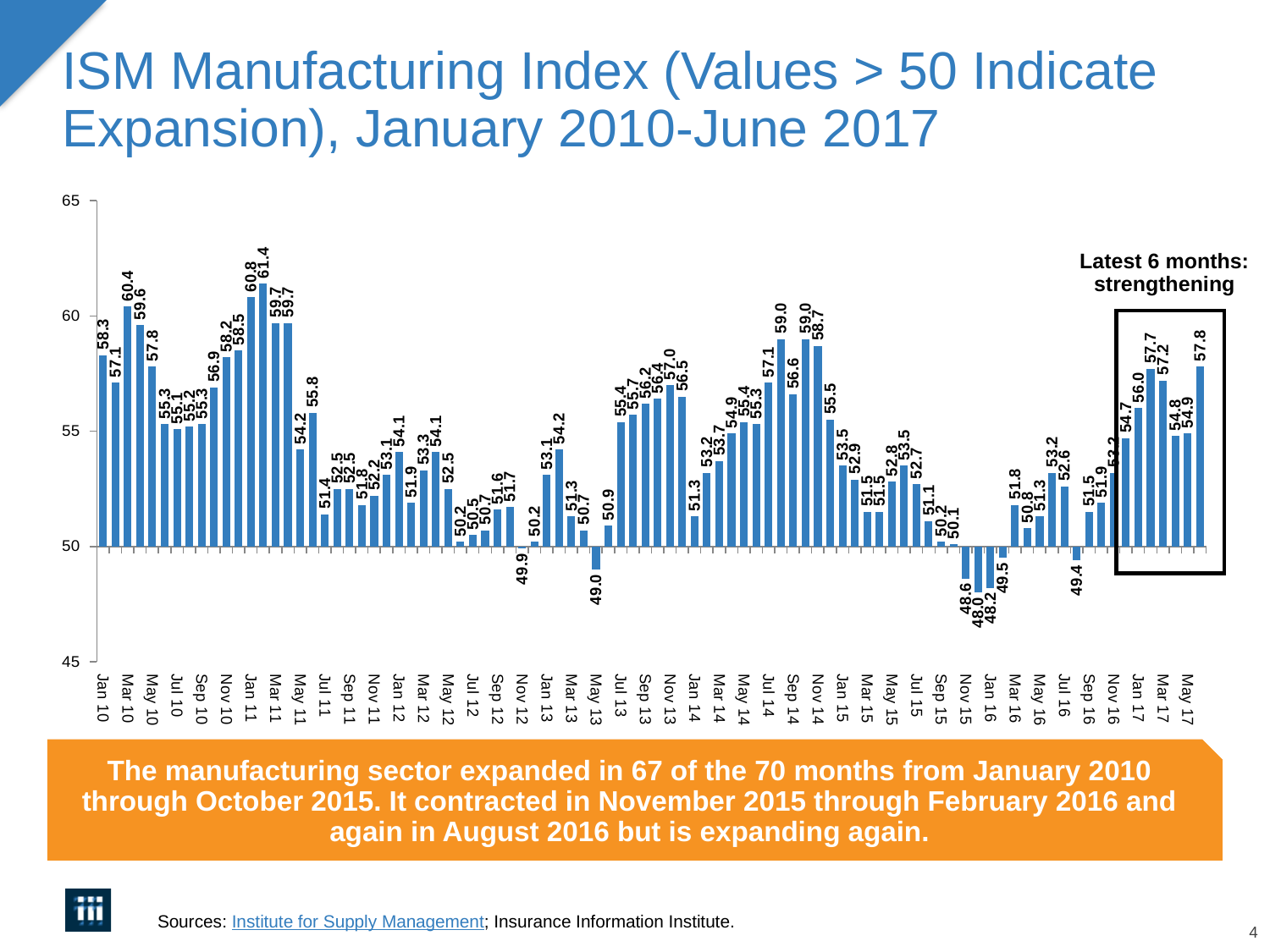
What is the ISM Manufacturing Index value for the last bar, Jun 17? 57.8 What is the lowest value shown on the chart? 48.0 What is the highest value shown on the chart? 61.4 How many bars on the chart have values below 50? 7 What is the ISM Manufacturing Index value for Jan 10? 58.3 What is the difference between the highest value (61.4) and the lowest value (48.0) on the chart? 13.4 Is the value for Jan 10 greater or less than 55? greater What is the ISM Manufacturing Index value for Mar 10? 60.4 What is the range of the vertical axis on the chart? 45 to 65 Which is larger, the value for Jan 10 or the value for Jun 17? Jan 10 What does the annotation in the boxed area at the right of the chart say? Latest 6 months: strengthening What type of chart is shown on the slide? bar chart